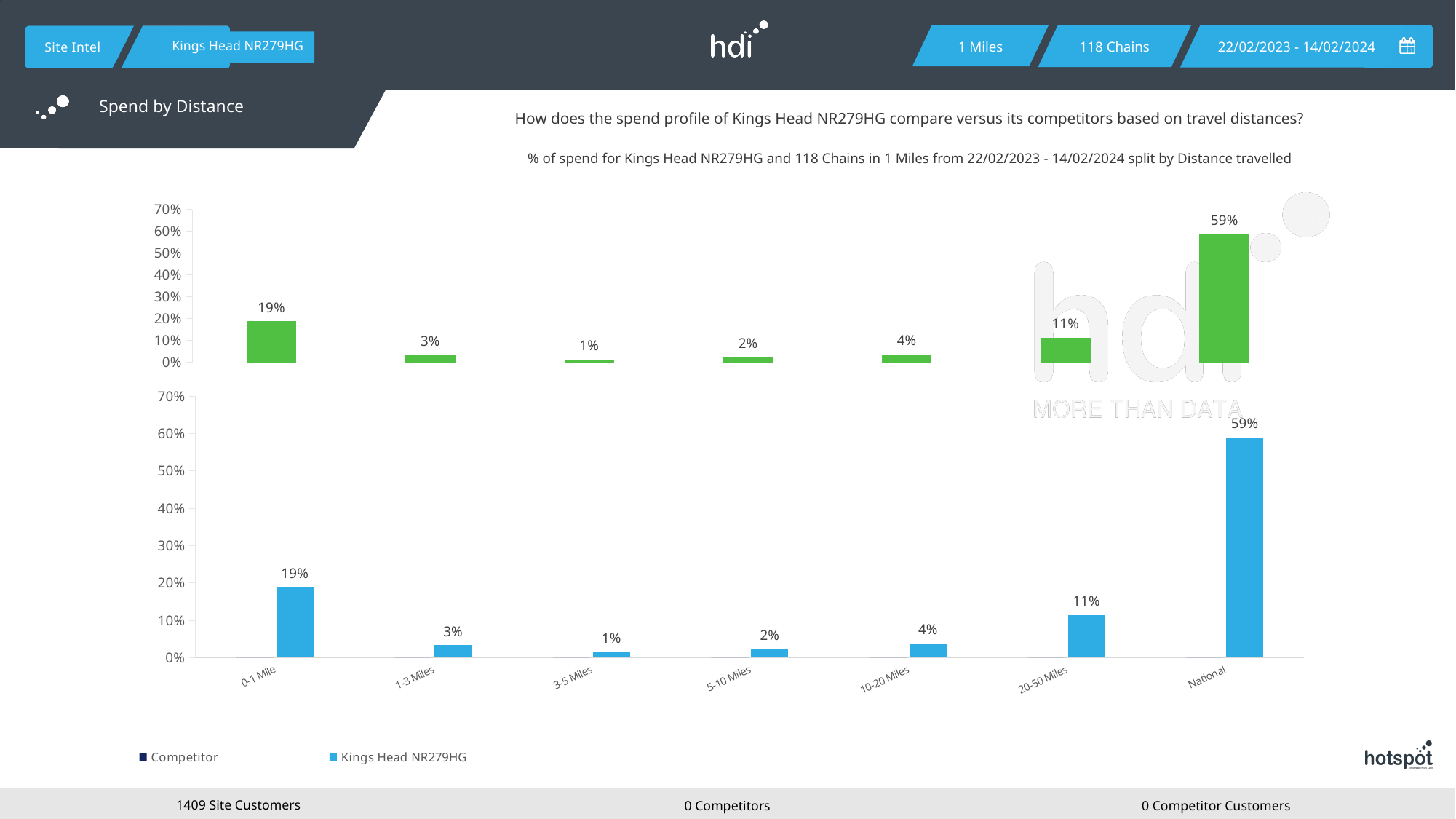
How many series does the legend list? 2 On the bottom chart, what is the value for the 3-5 Miles category? 1% What kind of chart is the bottom chart? bar chart How many distance categories are shown on the x axis of the bottom chart? 7 On the bottom chart, which is larger: the value for 10-20 Miles or the value for 5-10 Miles? 10-20 Miles On the bottom chart, is the value for National greater or less than 50%? greater On the bottom chart, what is the difference between the National value and the 0-1 Mile value? 40% On the bottom chart, which distance category has the lowest value? 3-5 Miles On the bottom chart, which distance category has the highest value? National On the bottom chart, what is the value for the National category? 59% On the bottom chart, what is the value for the 20-50 Miles category? 11% On the bottom chart, what is the value for Kings Head NR279HG in the 0-1 Mile category? 19%